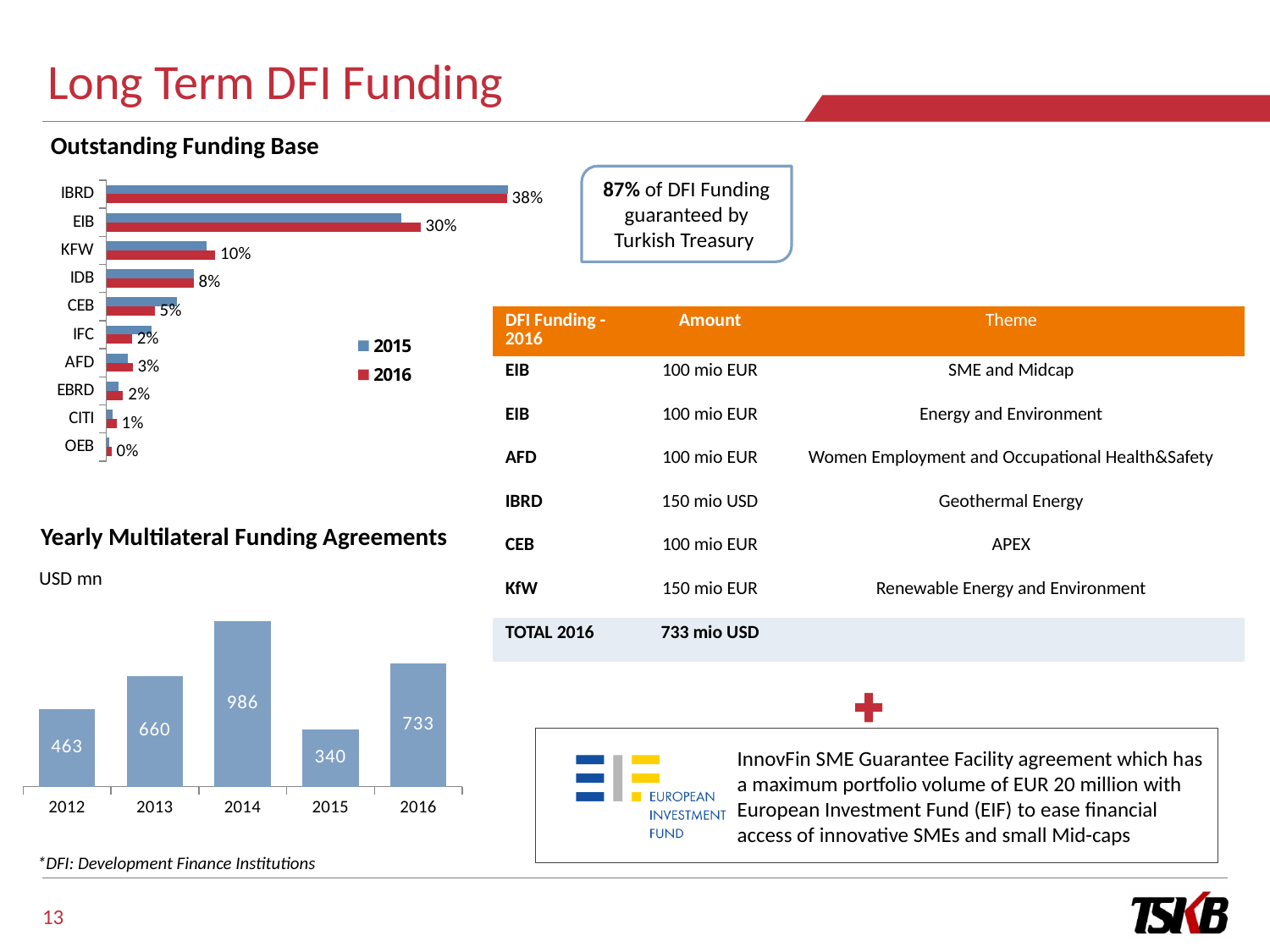
In the Outstanding Funding Base chart, how many series does the legend list? 2 In the Outstanding Funding Base chart, what is the 2016 value for IBRD? 38% In the Yearly Multilateral Funding Agreements chart, what is the value for 2014? 986 In the Outstanding Funding Base chart, which institution has the highest 2016 share? IBRD In the Yearly Multilateral Funding Agreements chart, which year has the lowest value? 2015 What kind of chart is the Outstanding Funding Base chart? Bar chart In the Outstanding Funding Base chart, what is the 2016 value for EIB? 30% In the Yearly Multilateral Funding Agreements chart, how many years are shown? 5 In the Yearly Multilateral Funding Agreements chart, which is larger, the value for 2012 or 2013? 2013 In the Outstanding Funding Base chart, which institution has the lowest 2016 share? OEB In the Outstanding Funding Base chart, how many institutions are listed on the axis? 10 In the Yearly Multilateral Funding Agreements chart, what is the difference between the 2016 and 2015 values? 393